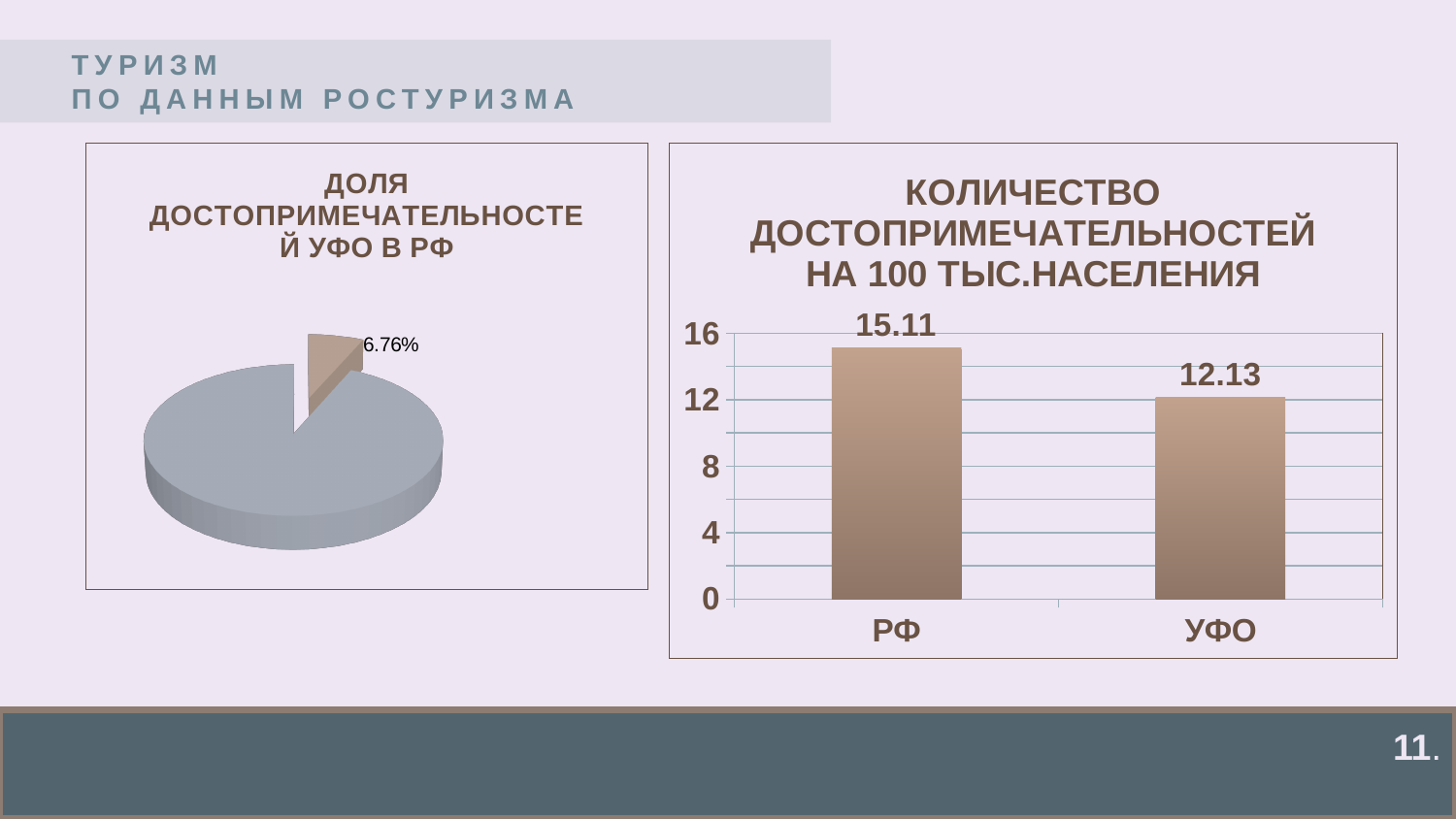
In the pie chart titled «ДОЛЯ ДОСТОПРИМЕЧАТЕЛЬНОСТЕЙ УФО В РФ», what share is shown for the labelled slice? 6.76% In the bar chart titled «КОЛИЧЕСТВО ДОСТОПРИМЕЧАТЕЛЬНОСТЕЙ НА 100 ТЫС.НАСЕЛЕНИЯ», what is the value for УФО? 12.13 What kind of chart is the chart on the right of the slide? bar chart In the bar chart on the right, is the value for УФО greater or less than 8? greater What kind of chart is the chart on the left of the slide? pie chart What is the title of the bar chart on the right of the slide? КОЛИЧЕСТВО ДОСТОПРИМЕЧАТЕЛЬНОСТЕЙ НА 100 ТЫС.НАСЕЛЕНИЯ In the bar chart on the right, what is the difference between the values for РФ and УФО? 2.98 In the bar chart on the right, which is larger: the value for РФ or the value for УФО? РФ How many categories are shown in the bar chart on the right? 2 In the bar chart on the right, which category has the lowest value? УФО In the bar chart titled «КОЛИЧЕСТВО ДОСТОПРИМЕЧАТЕЛЬНОСТЕЙ НА 100 ТЫС.НАСЕЛЕНИЯ», what is the value for РФ? 15.11 In the bar chart on the right, which category has the highest value? РФ